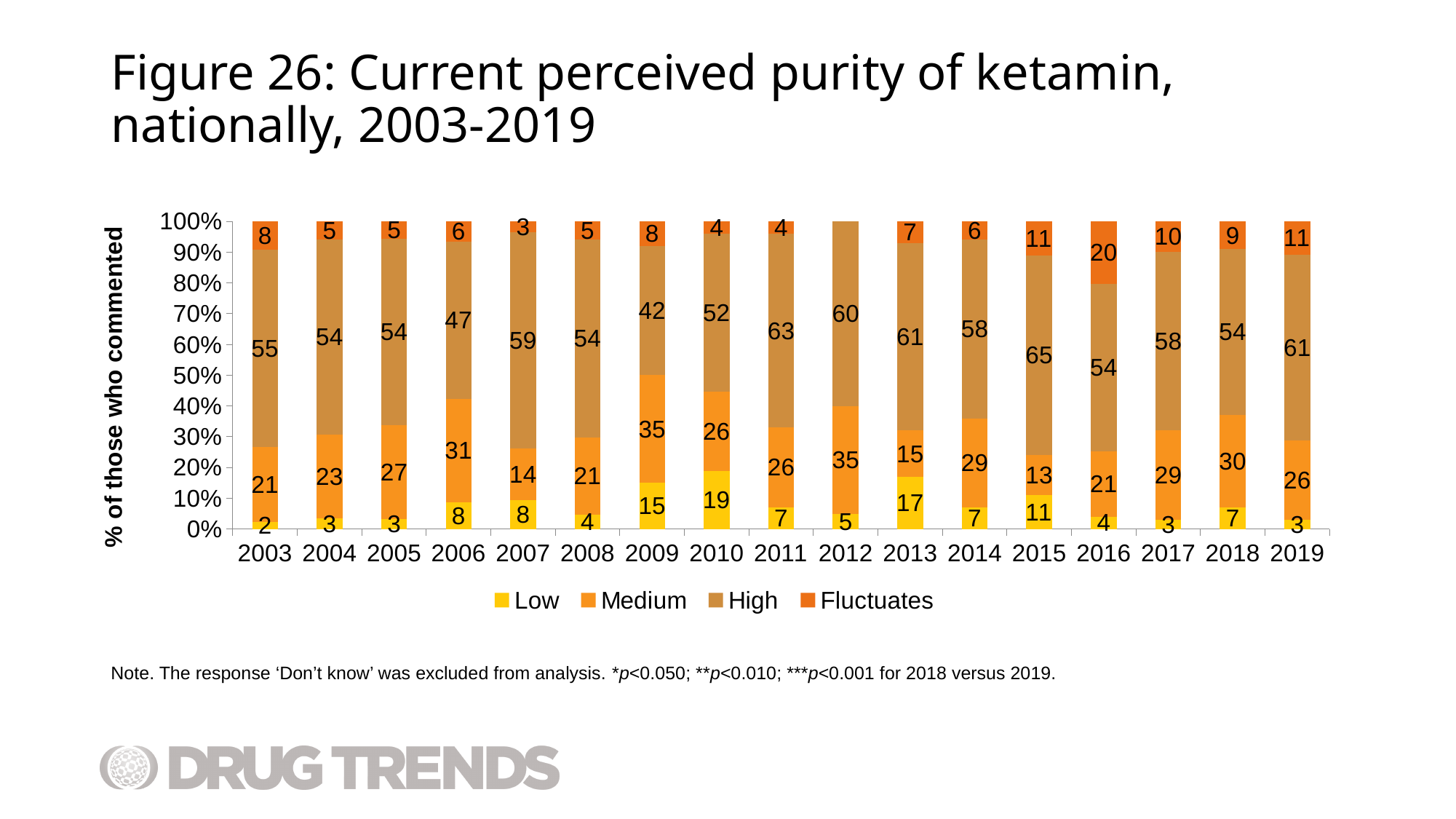
What is the value for Fluctuates in 2016? 20 How many years are shown on the x axis? 17 What is the value for High in 2015? 65 Which is larger, the Fluctuates value in 2016 or in 2019? 2016 How many series does the legend list? 4 What kind of chart is shown on the slide? Stacked bar chart In which year is the High value the largest? 2015 What is the value for Low in 2010? 19 What is the label of the y axis? % of those who commented What is the difference between the Medium values in 2009 and 2013? 20 In which year is the Low value the smallest? 2003 What is the value for Medium in 2007? 14